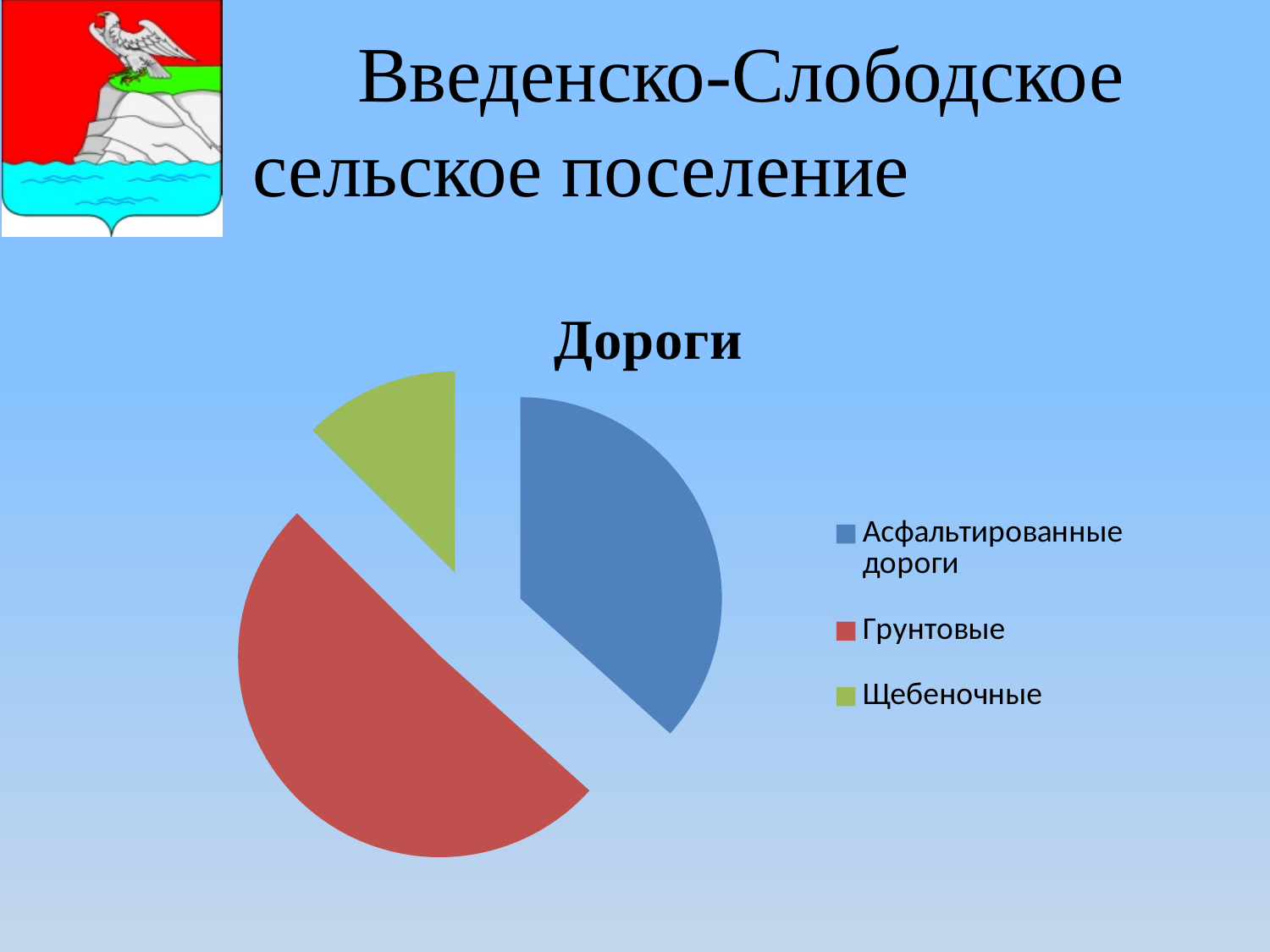
Which category has the largest slice of the pie? Грунтовые Which slice is larger: Грунтовые or Асфальтированные дороги? Грунтовые How many slices does the pie chart have? 3 How many entries does the legend list? 3 What colour is the slice for Грунтовые? red What kind of chart is shown on the slide? pie chart Which category has the smallest slice of the pie? Щебеночные Which slice is larger: Асфальтированные дороги or Щебеночные? Асфальтированные дороги What is the title of the chart? Дороги